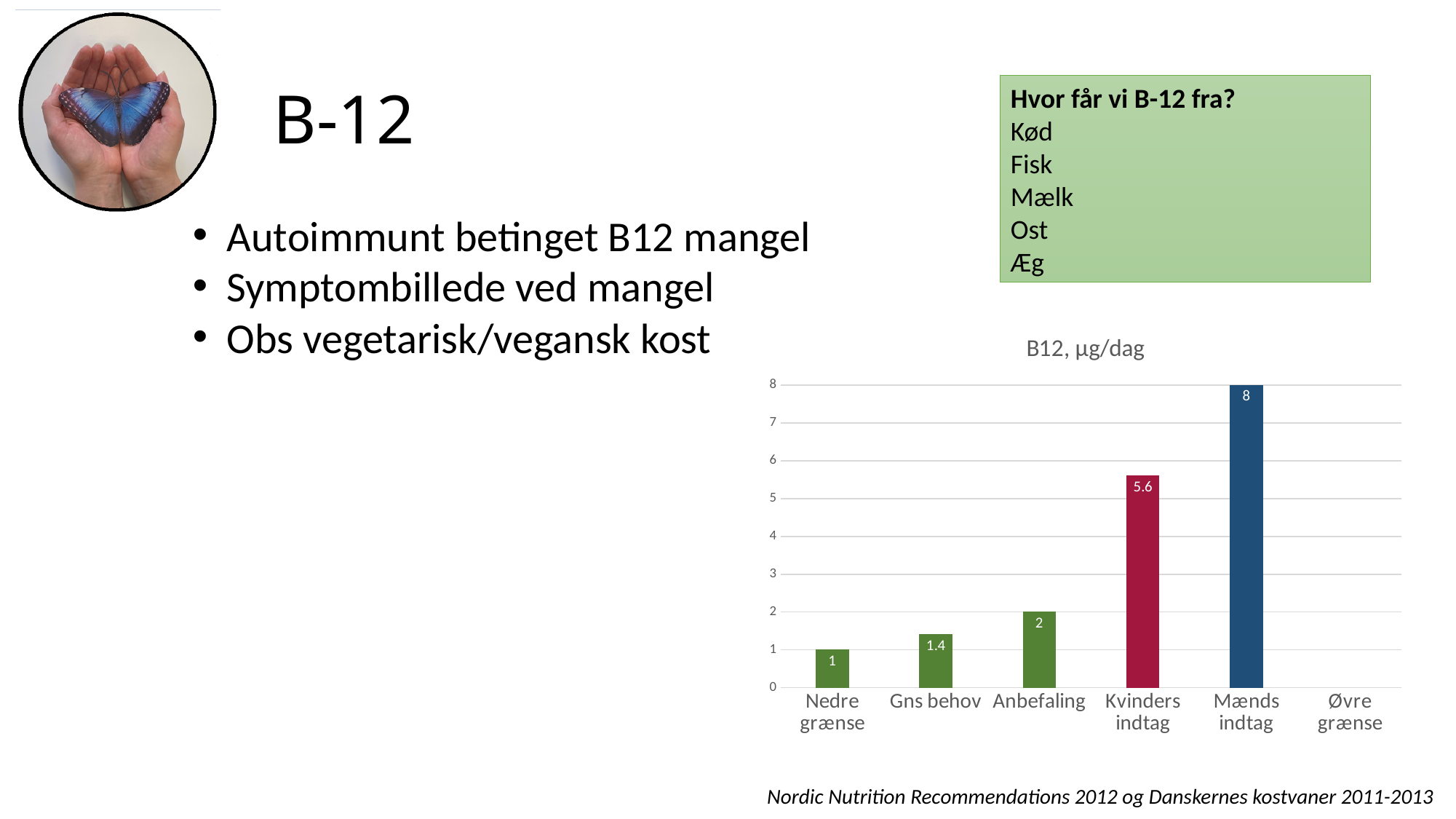
Which category with a visible bar has the lowest value in the B12, µg/dag chart? Nedre grænse What is the difference between Mænds indtag and Kvinders indtag in the B12, µg/dag chart? 2.4 Which category has the highest value in the B12, µg/dag chart? Mænds indtag What is the title of the chart on the slide? B12, µg/dag What is the value for Kvinders indtag in the B12, µg/dag chart? 5.6 What kind of chart is the B12, µg/dag chart? bar chart How many categories are shown on the x axis of the B12, µg/dag chart? 6 What is the value for Gns behov in the B12, µg/dag chart? 1.4 What is the value for Anbefaling in the B12, µg/dag chart? 2 What is the value for Mænds indtag in the B12, µg/dag chart? 8 Which is larger in the B12, µg/dag chart, Kvinders indtag or Anbefaling? Kvinders indtag What is the difference between Anbefaling and Gns behov in the B12, µg/dag chart? 0.6